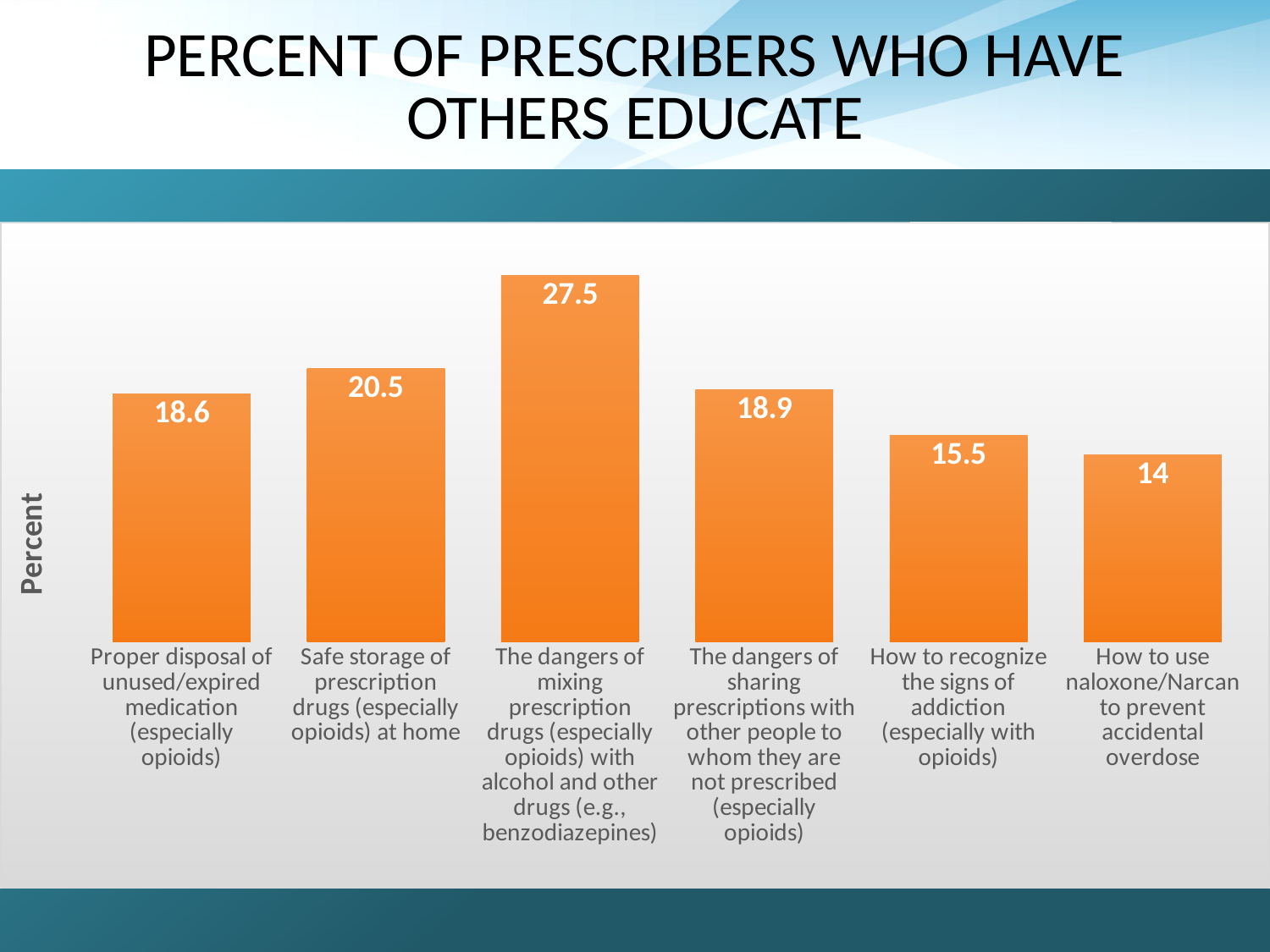
How many categories are shown in the chart? 6 What is the value for 'How to recognize the signs of addiction (especially with opioids)'? 15.5 Which is larger: the value for 'The dangers of sharing prescriptions with other people to whom they are not prescribed (especially opioids)' or the value for 'Proper disposal of unused/expired medication (especially opioids)'? The dangers of sharing prescriptions with other people to whom they are not prescribed (especially opioids) What kind of chart is shown on the slide? Bar chart What is the label on the vertical axis of the chart? Percent What is the difference between the value for 'Safe storage of prescription drugs (especially opioids) at home' and the value for 'Proper disposal of unused/expired medication (especially opioids)'? 1.9 Which category has the highest value? The dangers of mixing prescription drugs (especially opioids) with alcohol and other drugs (e.g., benzodiazepines) What is the difference between the value for 'The dangers of mixing prescription drugs (especially opioids) with alcohol and other drugs (e.g., benzodiazepines)' and the value for 'How to use naloxone/Narcan to prevent accidental overdose'? 13.5 What is the value for 'How to use naloxone/Narcan to prevent accidental overdose'? 14 What is the title of the slide? PERCENT OF PRESCRIBERS WHO HAVE OTHERS EDUCATE Which category has the lowest value? How to use naloxone/Narcan to prevent accidental overdose What is the value for 'Safe storage of prescription drugs (especially opioids) at home'? 20.5